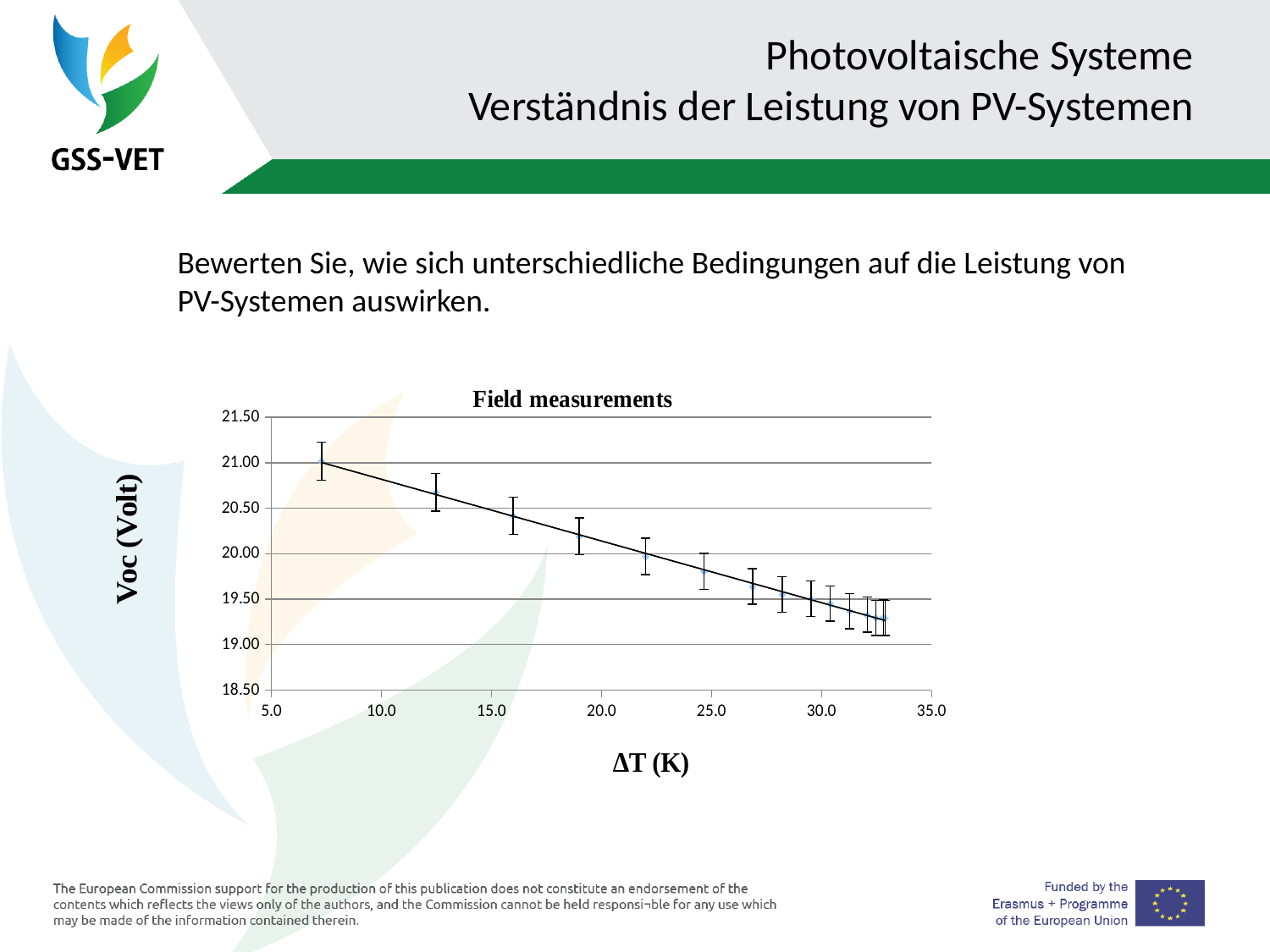
Which is larger: the Voc value at about ΔT = 16 or the Voc value at about ΔT = 30? the value at about ΔT = 16 Do the Voc values rise or fall as ΔT increases along the x axis? fall What kind of chart is shown on the slide? Line chart with error bars (scatter plot with trend line) What is the label of the y axis of the chart? Voc (Volt) What is the title of the chart? Field measurements Is the Voc value for the data point at about ΔT = 12.5 greater or less than 20.00? greater Is the Voc value for the rightmost data point (highest ΔT) greater or less than 20.00? less Is the Voc value for the data point at about ΔT = 22 greater or less than 20.50? less Which data point has the highest Voc value: the one at the lowest ΔT or the one at the highest ΔT? the one at the lowest ΔT Which data point has the lowest Voc value: the leftmost point or the rightmost point? the rightmost point